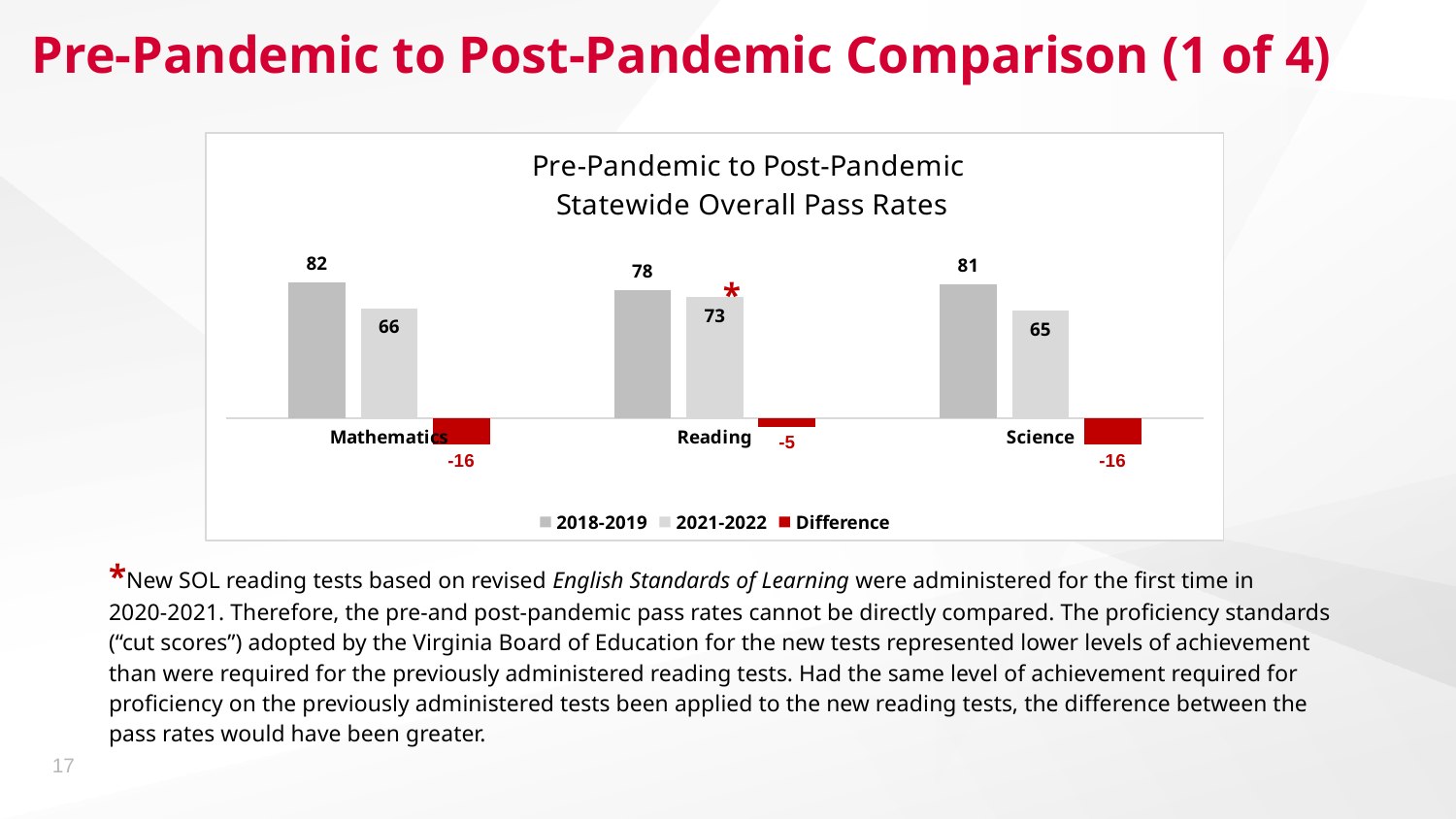
What is the title of the chart? Pre-Pandemic to Post-Pandemic Statewide Overall Pass Rates Which subject has the smallest drop in pass rate from 2018-2019 to 2021-2022? Reading Which is larger, the 2021-2022 pass rate for Mathematics or for Science? Mathematics How many series does the legend list? 3 What is the Difference value shown for Science? -16 What kind of chart is shown? Bar chart What was the 2018-2019 pass rate for Mathematics? 82 What is the difference between the 2018-2019 and 2021-2022 pass rates for Reading? 5 Which subject had the lowest 2021-2022 pass rate? Science Which subject had the highest 2018-2019 pass rate? Mathematics What was the 2021-2022 pass rate for Reading? 73 How many subjects are shown on the x axis? 3